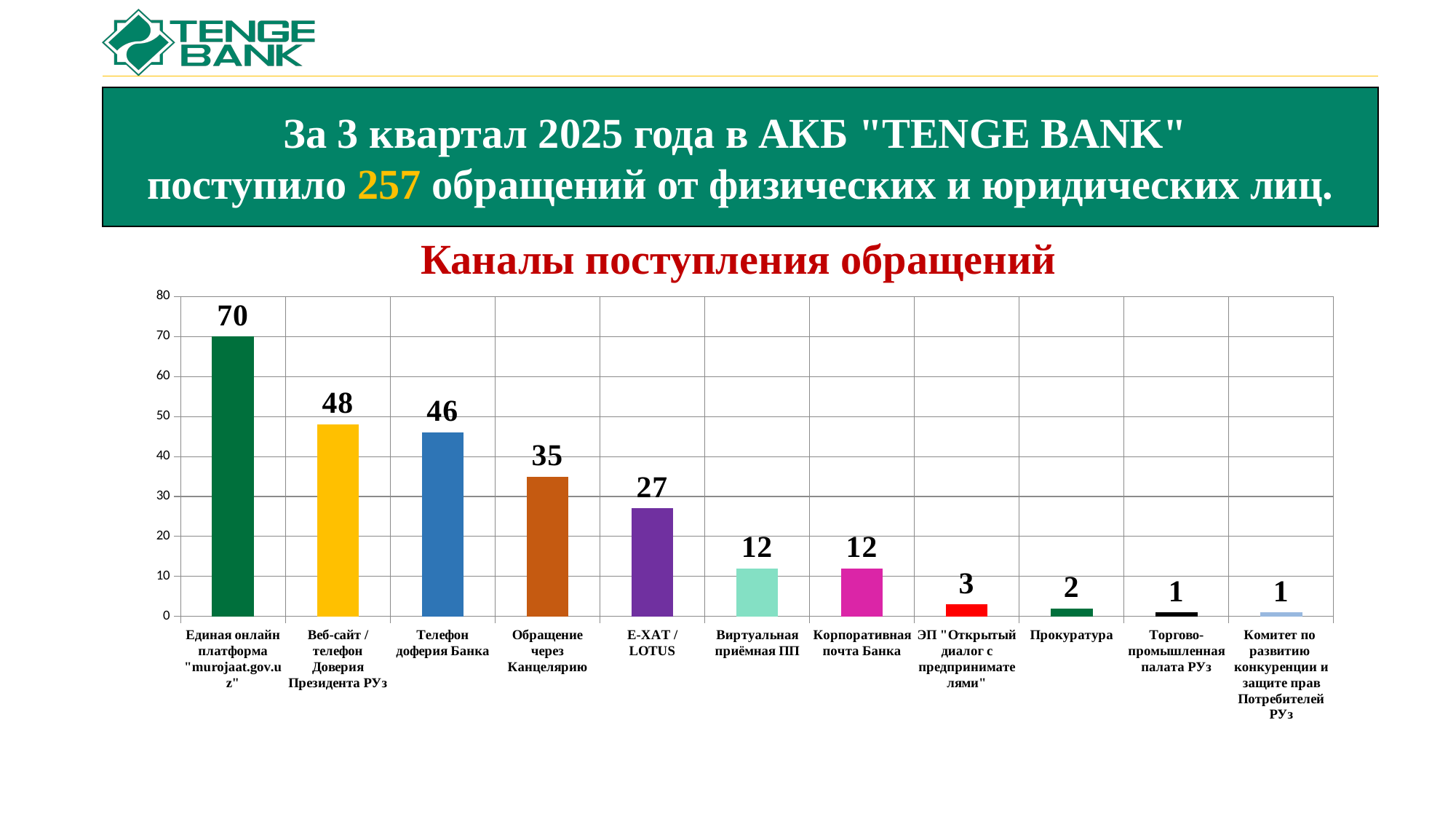
Which channel has the highest value? Единая онлайн платформа "murojaat.gov.uz" Is the value for Виртуальная приёмная ПП greater or less than 20? less What is the title of the chart? Каналы поступления обращений What kind of chart is shown on the slide? bar chart What is the difference between the values for Единая онлайн платформа "murojaat.gov.uz" and Веб-сайт / телефон Доверия Президента РУз? 22 Which is larger: the value for Веб-сайт / телефон Доверия Президента РУз or the value for Телефон доферия Банка? Веб-сайт / телефон Доверия Президента РУз How many categories (channels) are shown in the chart? 11 What is the value for Прокуратура? 2 Do the values rise or fall from left to right along the x axis? fall What is the value for Обращение через Канцелярию? 35 What is the value for E-XAT / LOTUS? 27 What is the value for Единая онлайн платформа "murojaat.gov.uz"? 70